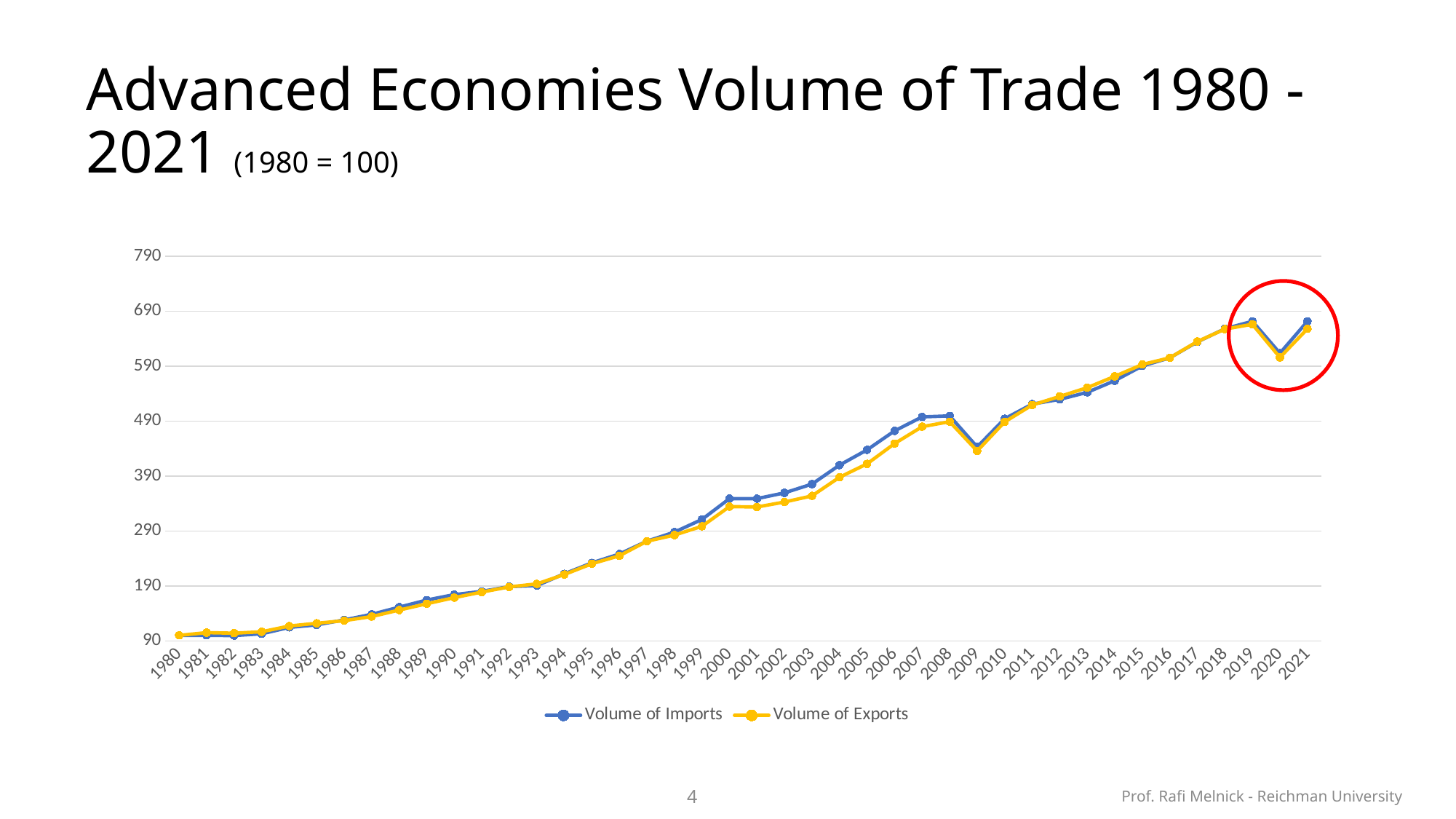
How many years are plotted along the x axis? 42 Which year is highlighted by the red circle as showing a dip in both series? 2020 Do the values generally rise or fall from 1980 to 2021? Rise What kind of chart is shown on the slide? Line chart What are the two series named in the legend? Volume of Imports and Volume of Exports Is the value for Volume of Exports in 2017 greater or less than 590? greater Is the value for Volume of Imports in 2020 greater or less than 690? less In 2005, which is larger: Volume of Imports or Volume of Exports? Volume of Imports Is the value for Volume of Exports in 2009 greater or less than 490? less How many series does the legend list? 2